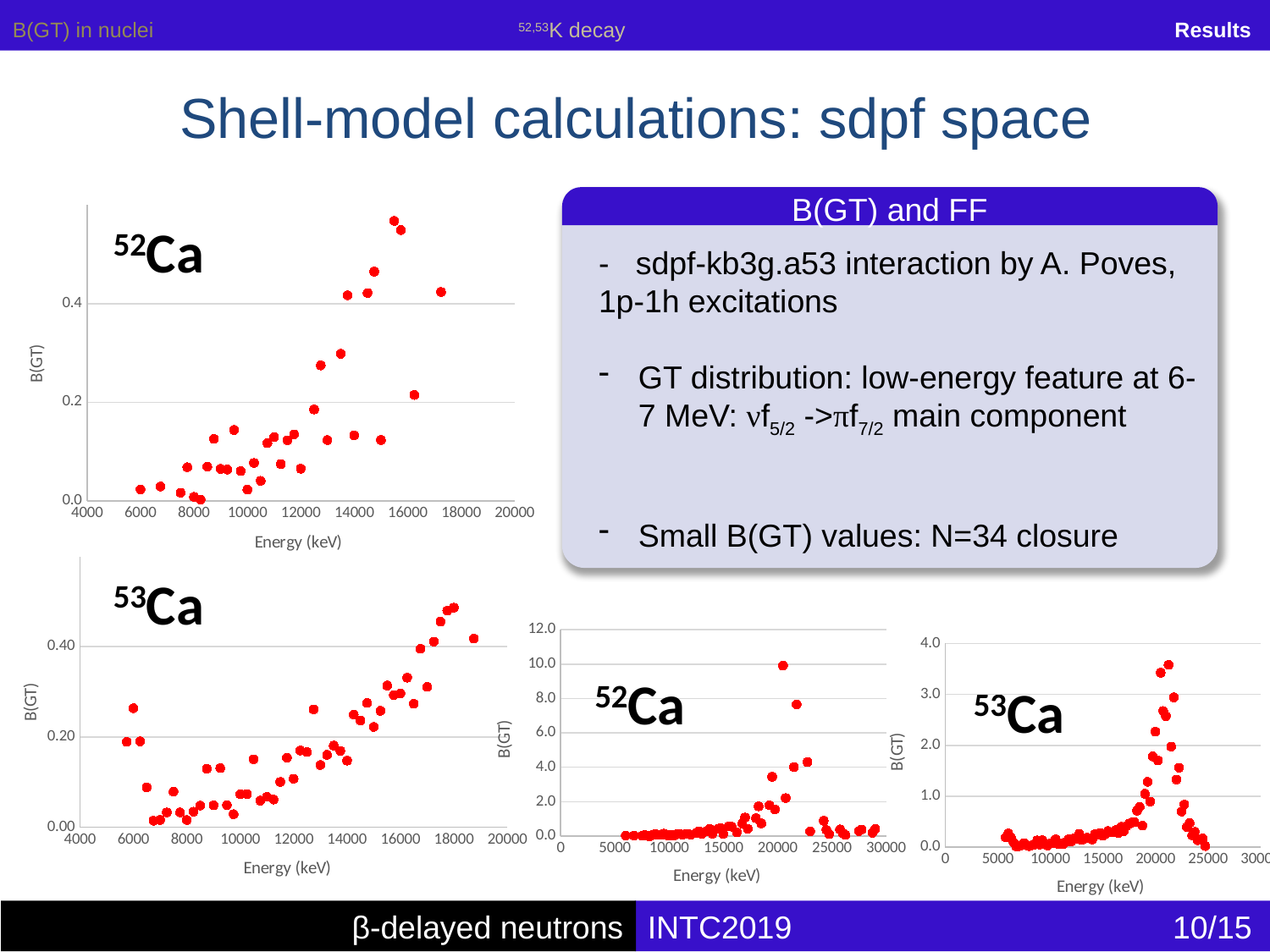
What is the x-axis title of the top-left 52Ca chart? Energy (keV) In the bottom-right 53Ca chart (y axis up to 4.0), is the highest plotted point greater or less than 3.0? greater In the top-left 52Ca chart, do the B(GT) values generally rise or fall as energy increases from 6000 to 16000 keV? rise What is the highest tick value on the x axis of the bottom-right 53Ca chart? 30000 In the top-left 52Ca chart, is the highest plotted B(GT) value greater or less than 0.4? greater In the bottom-left 53Ca chart (y axis up to 0.40), is the highest plotted point greater or less than 0.40? greater What kind of chart is the top-left 52Ca chart? scatter chart What colour are the data points in the bottom-left 53Ca chart? red What is the highest tick value on the y axis of the bottom-middle 52Ca chart? 12.0